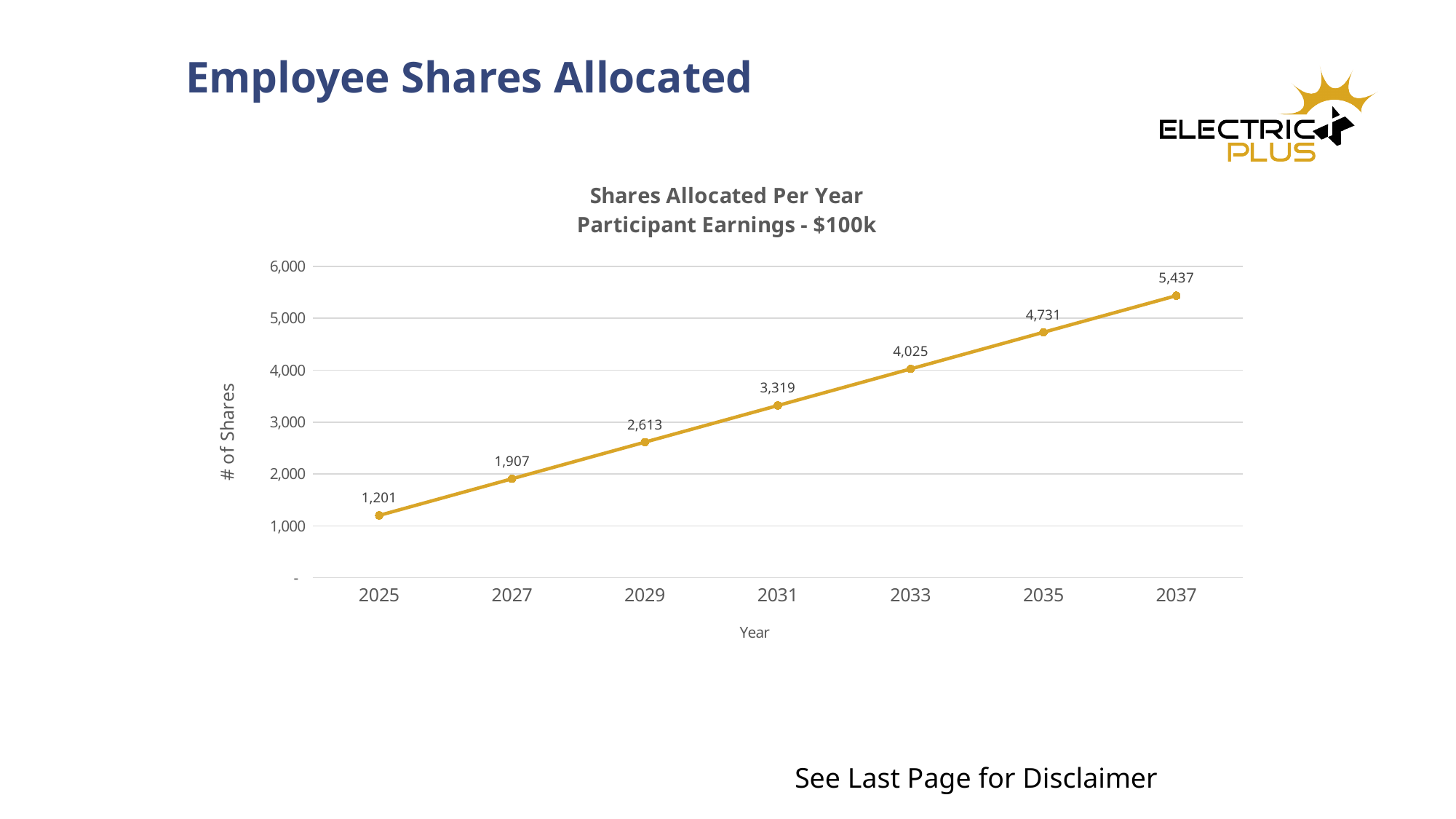
What is the number of shares allocated in 2037? 5,437 Which year has the lowest number of shares allocated? 2025 What kind of chart is shown on the slide? Line chart What is the difference in shares allocated between 2033 and 2029? 1,412 How many years are plotted on the chart? 7 Which year has the highest number of shares allocated? 2037 Which year has more shares allocated, 2029 or 2035? 2035 What is the number of shares allocated in 2025? 1,201 Do the shares allocated rise or fall from 2025 to 2037? Rise What is the difference in shares allocated between 2037 and 2025? 4,236 Is the value for 2033 greater or less than 4,000? greater What is the number of shares allocated in 2031? 3,319